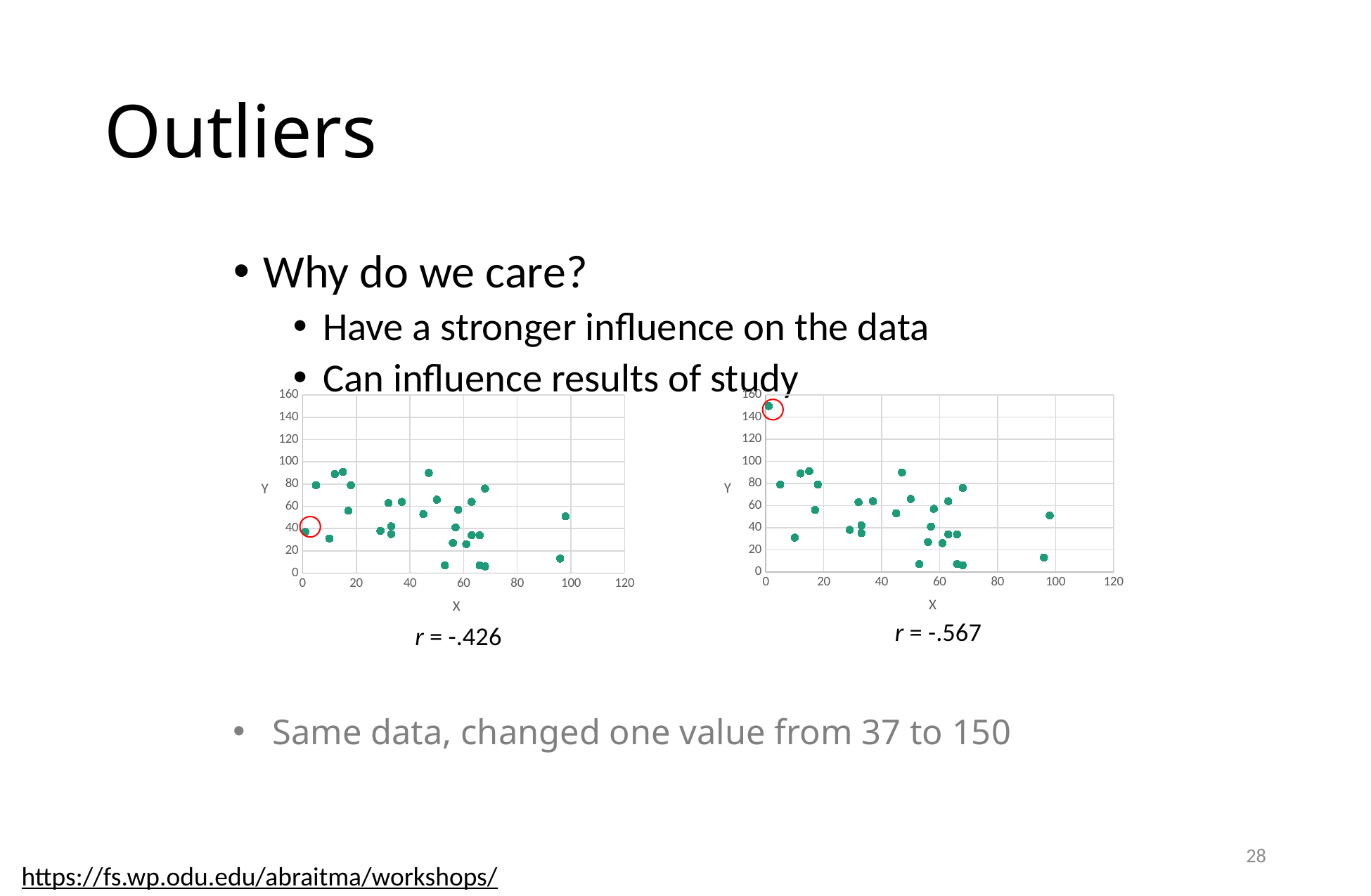
In the right chart, which point has the highest Y value? the circled point near X = 0 What kind of chart is the right chart? scatter chart What is the highest tick value shown on the Y axis of the right chart? 160 In the right chart, do the Y values generally rise or fall as X increases? fall In the right chart, is the value of the circled point greater or less than 140? greater In the left chart, is the Y value of the point with the largest X (near X = 100) greater or less than 40? greater How many charts are shown on the slide? 2 What kind of chart is the left chart? scatter chart What is the label of the vertical axis on the left chart? Y In the left chart, is the value of the circled point greater or less than 60? less What is the label of the horizontal axis on the right chart? X